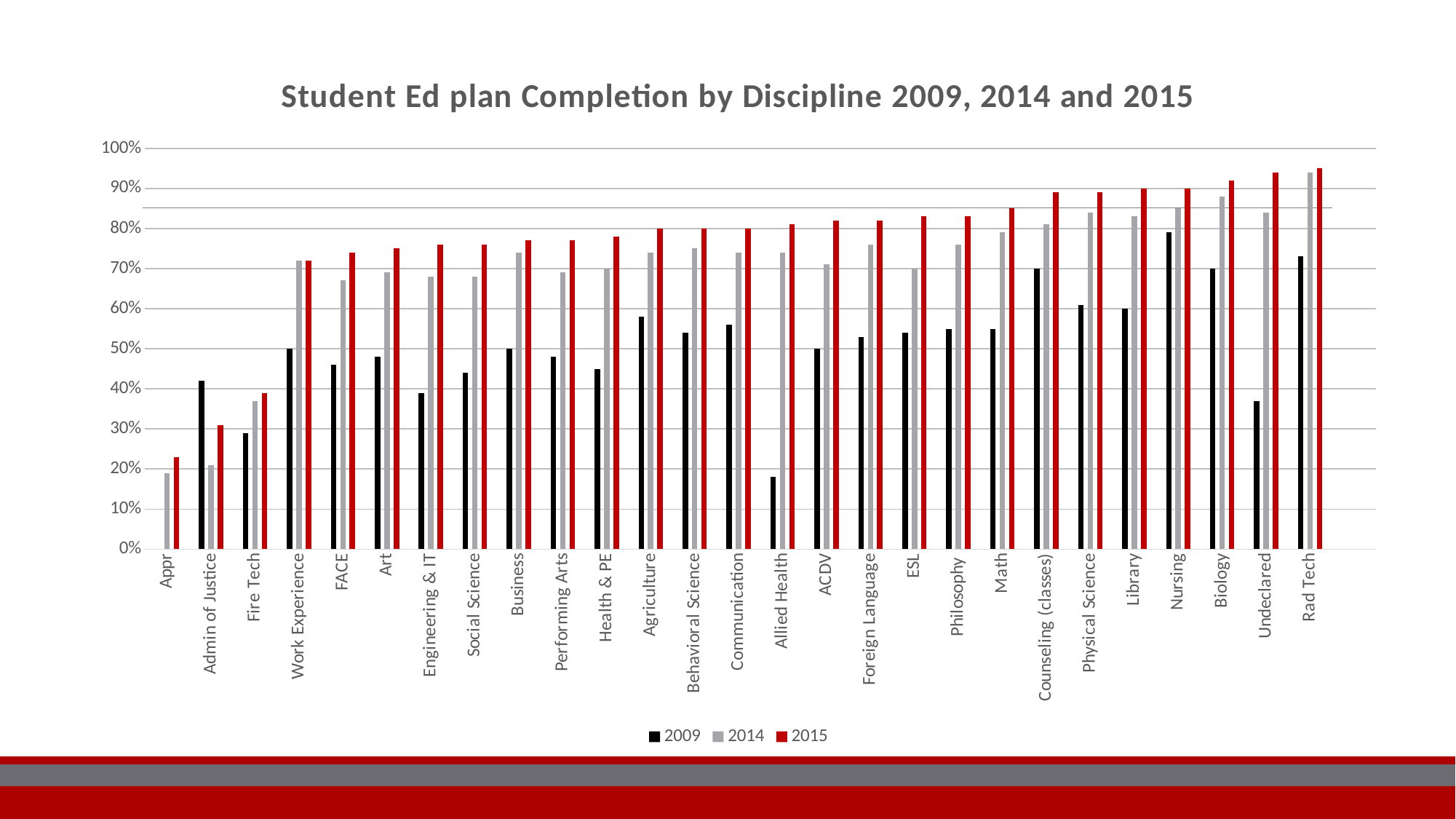
Which discipline has the lowest 2015 value? Appr Which discipline has the lowest 2009 value? Allied Health What kind of chart is shown on the slide? bar chart How many disciplines are shown on the x axis? 27 What is the title of the chart? Student Ed plan Completion by Discipline 2009, 2014 and 2015 Which discipline has the highest 2015 value? Rad Tech Which discipline has the highest 2009 value? Nursing Do the 2015 values generally rise or fall moving left to right along the x axis? rise Is the 2015 value for Rad Tech greater or less than 90%? greater Is the 2009 value for Allied Health greater or less than 20%? less How many series does the legend list? 3 For Undeclared, which is larger: the 2009 value or the 2014 value? 2014